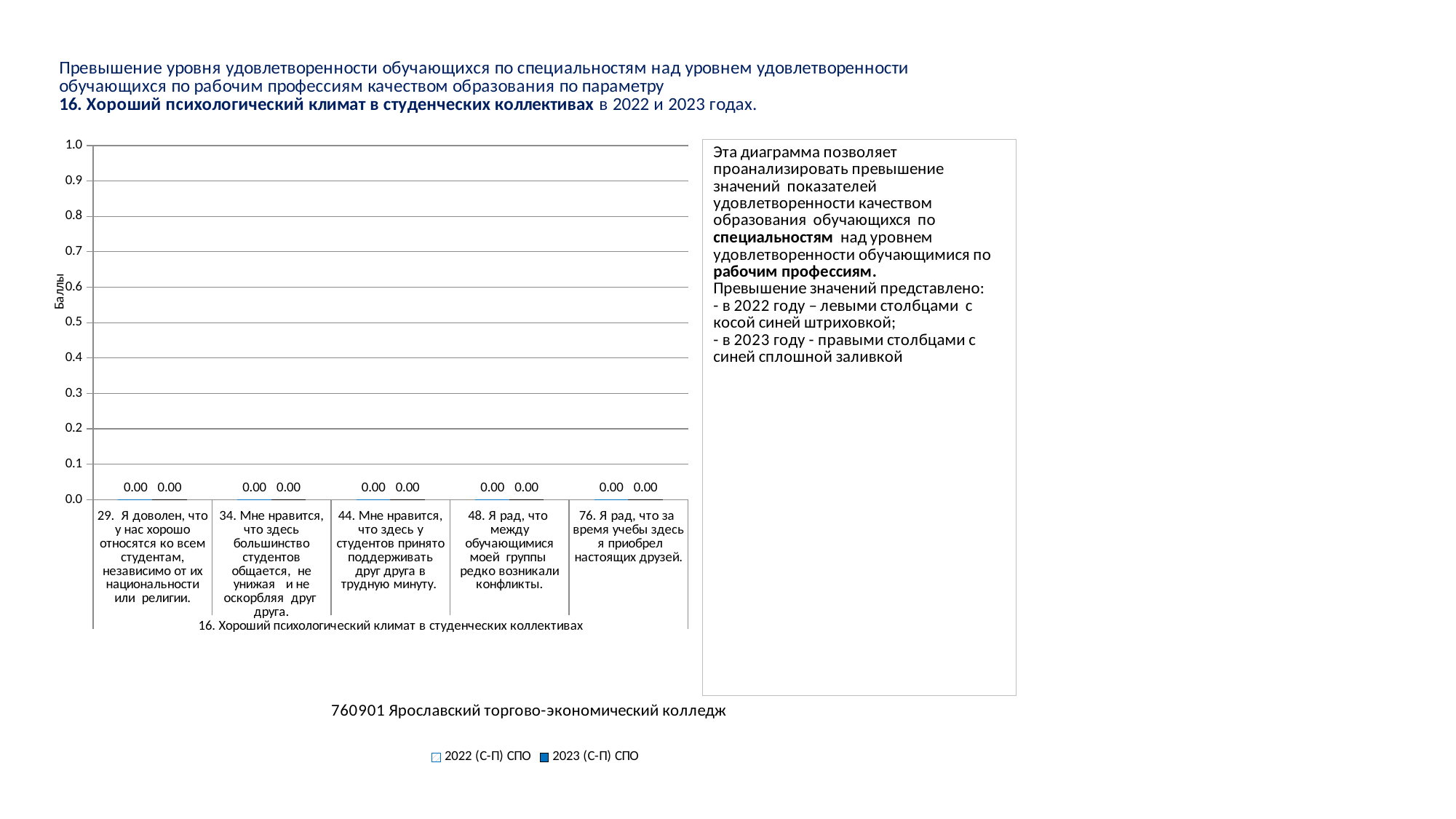
Is the value for the 2023 (С-П) СПО series for category 29 greater or less than 0.1? less How many series does the legend list? 2 What is the label of the y axis of the chart? Баллы What is the value for the 2023 (С-П) СПО series for category 76 (Я рад, что за время учебы здесь я приобрел настоящих друзей)? 0.00 What are the two series named in the legend? 2022 (С-П) СПО and 2023 (С-П) СПО What is the difference between the 2022 (С-П) СПО and 2023 (С-П) СПО values for category 34 (Мне нравится, что здесь большинство студентов общается, не унижая и не оскорбляя друг друга)? 0.00 How many categories are shown on the x axis of the chart? 5 What kind of chart is shown on the slide? bar chart What is the value for the 2023 (С-П) СПО series for category 48 (Я рад, что между обучающимися моей группы редко возникали конфликты)? 0.00 What is the value for the 2022 (С-П) СПО series for category 29 (Я доволен, что у нас хорошо относятся ко всем студентам...)? 0.00 What is the value for the 2022 (С-П) СПО series for category 44 (Мне нравится, что здесь у студентов принято поддерживать друг друга в трудную минуту)? 0.00